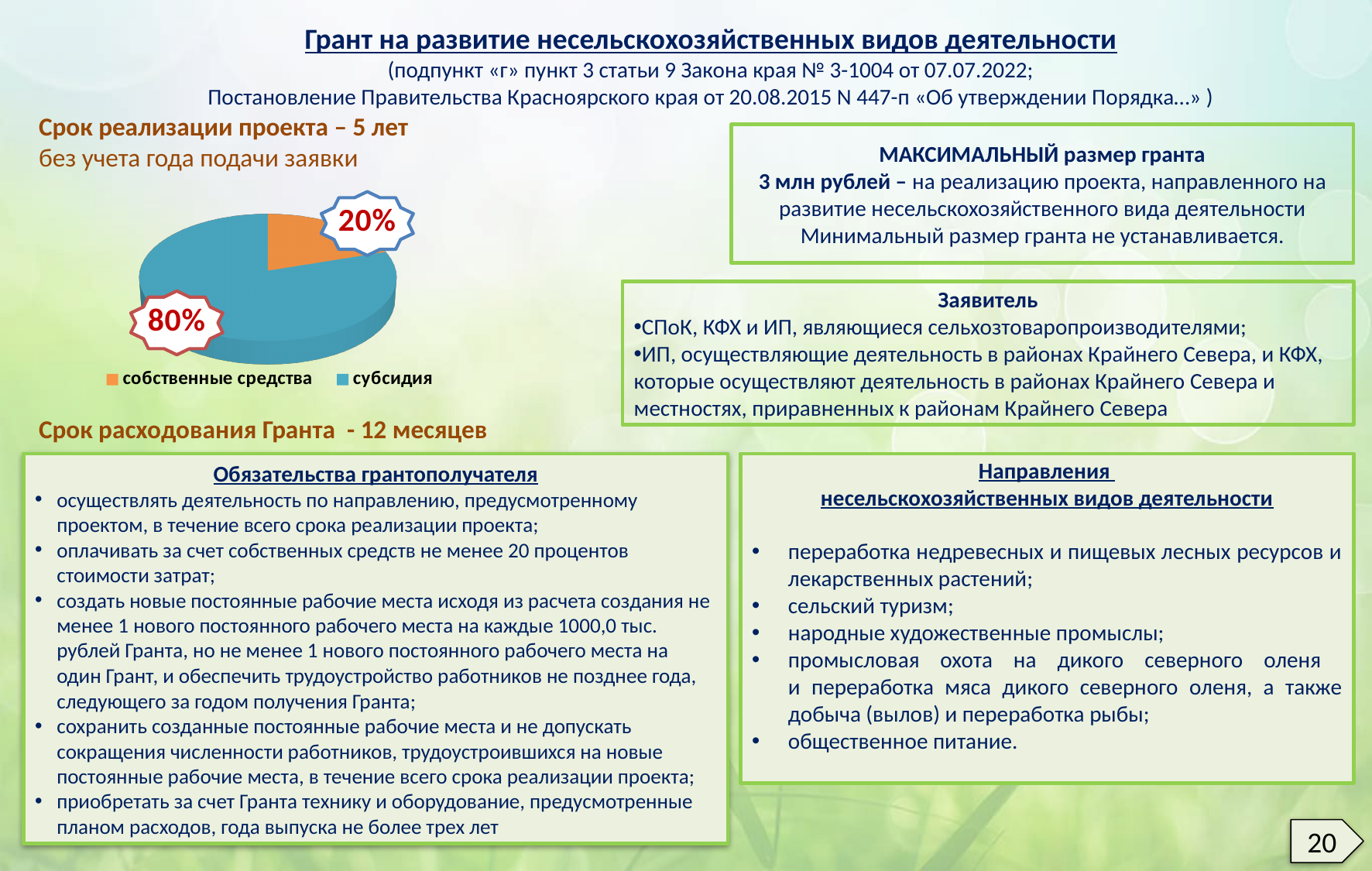
Which slice of the pie chart is the smallest? собственные средства What colour is the "субсидия" slice in the pie chart? blue What colour is the "собственные средства" slice in the pie chart? orange Which slice of the pie chart is the largest? субсидия What share of the pie does "субсидия" represent? 80% How many entries does the legend of the pie chart list? 2 What is the difference in percentage points between the "субсидия" slice and the "собственные средства" slice? 60 What share of the pie does "собственные средства" represent? 20% Which is larger in the pie chart: "субсидия" or "собственные средства"? субсидия What kind of chart is shown on the slide? pie chart How many slices does the pie chart have? 2